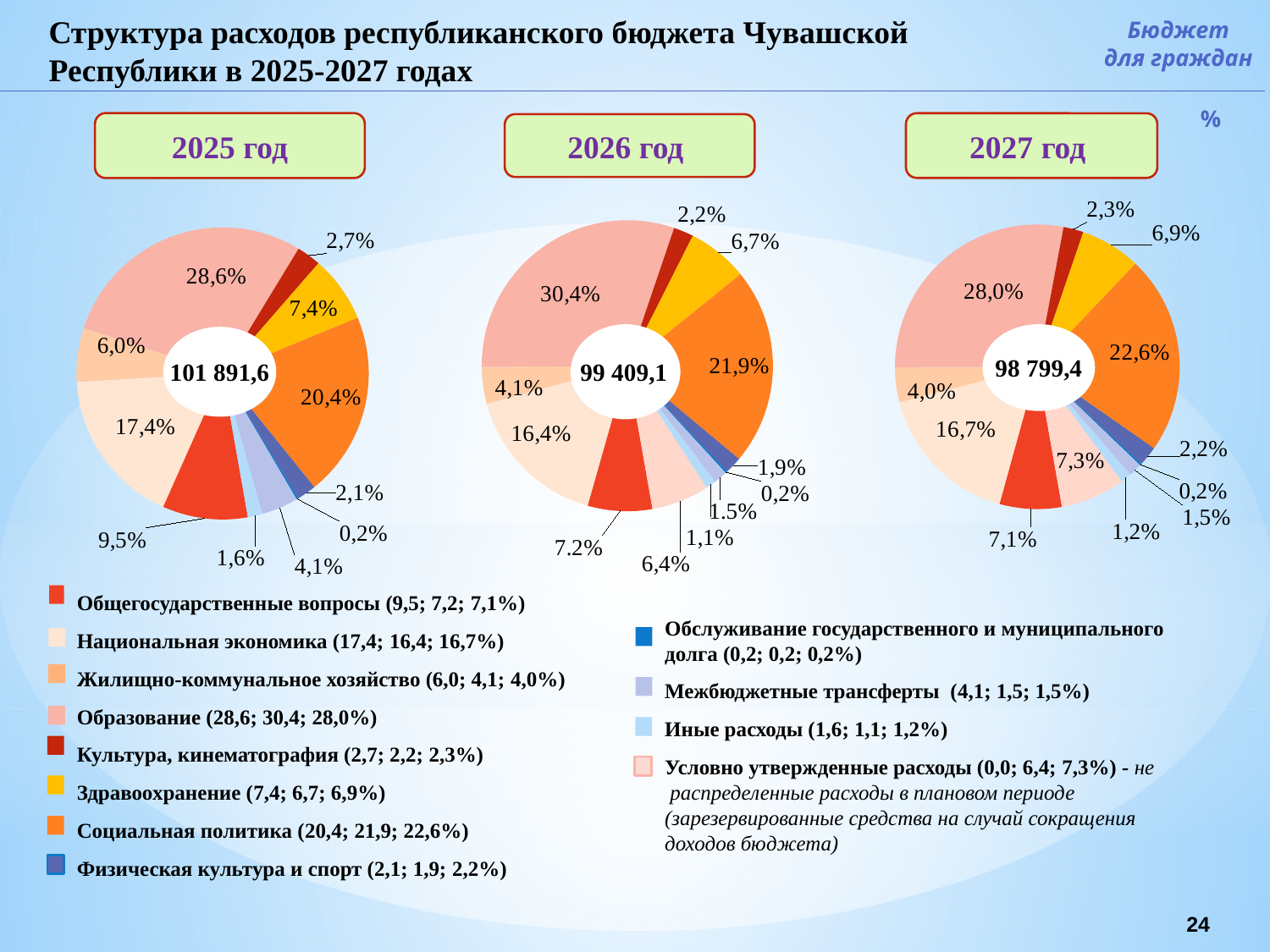
In the 2026 год chart, what share is shown for Социальная политика? 21,9% Across the 2025, 2026 and 2027 charts, does the share of Социальная политика rise or fall? rise What total value is printed in the centre of the 2025 год chart? 101 891,6 In the 2026 год chart, which category has the largest share? Образование What total value is printed in the centre of the 2027 год chart? 98 799,4 In the 2027 год chart, which is larger: the share of Социальная политика or the share of Национальная экономика? Социальная политика In the 2025 год chart, what share is shown for Образование? 28,6% In the 2025 год chart, which category has the smallest share? Обслуживание государственного и муниципального долга What kind of chart is used to show the expenditure structure for each year on this slide? pie chart How many pie charts are shown on the slide? 3 By how many percentage points does the share of Образование in the 2026 год chart exceed its share in the 2027 год chart? 2,4 In the 2027 год chart, what share is shown for Условно утвержденные расходы? 7,3%